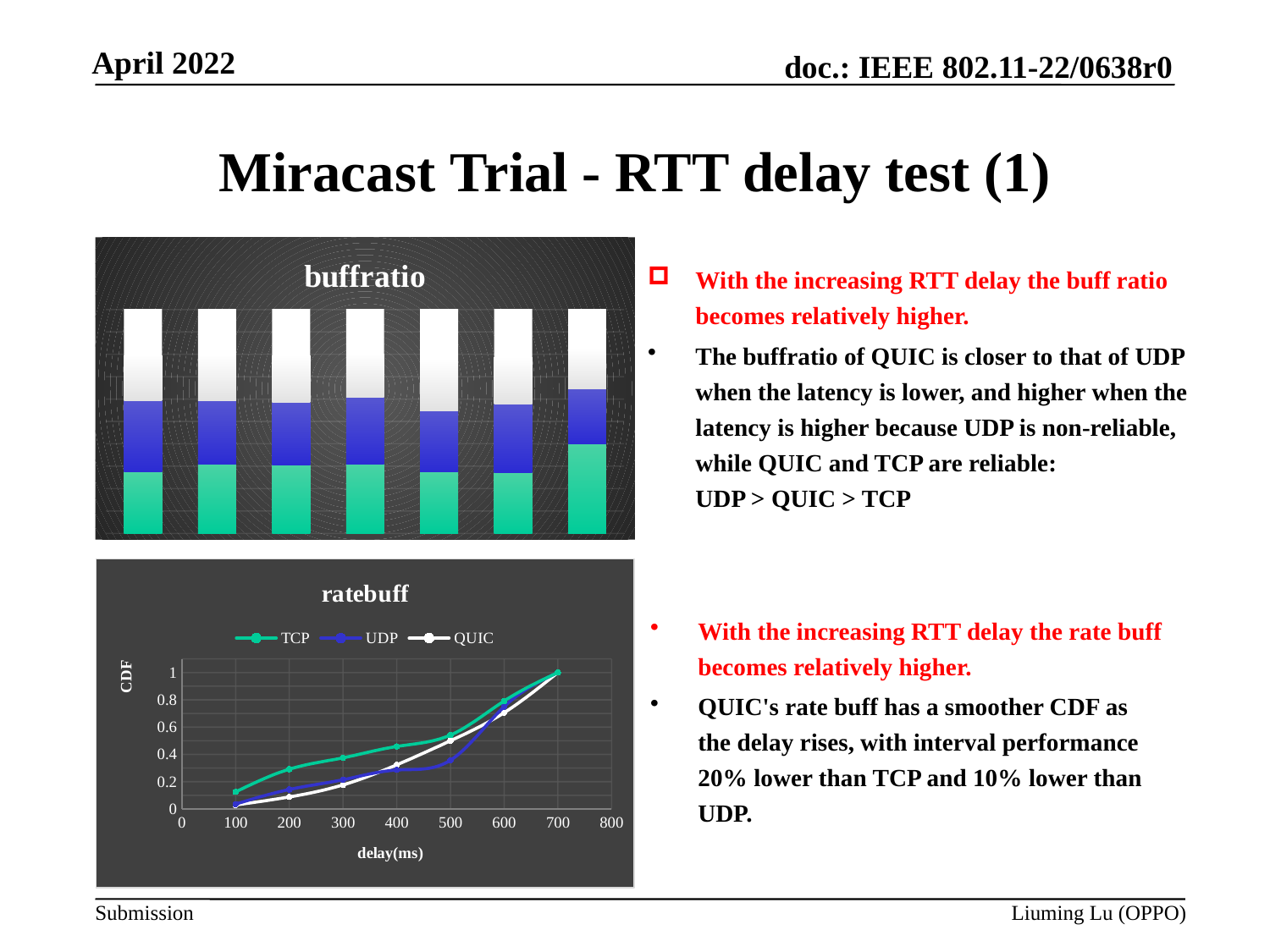
In the ratebuff chart, is the CDF value for UDP at 200 ms greater or less than 0.2? less In the ratebuff chart, what is the label of the x axis? delay(ms) In the ratebuff chart, do the CDF values rise or fall as delay increases? rise What kind of chart is the ratebuff chart? line chart How many series does the legend of the ratebuff chart list? 3 How many bars are shown in the buffratio chart? 7 In the ratebuff chart, what is the CDF value of TCP at a delay of 700 ms? 1 What kind of chart is the buffratio chart? bar chart What is the title of the upper chart on the slide? buffratio In the ratebuff chart, is the CDF value for TCP at 300 ms greater or less than 0.2? greater In the ratebuff chart, which series has the highest CDF value at a delay of 300 ms? TCP In the ratebuff chart, is the CDF value for QUIC at 400 ms greater or less than 0.4? less